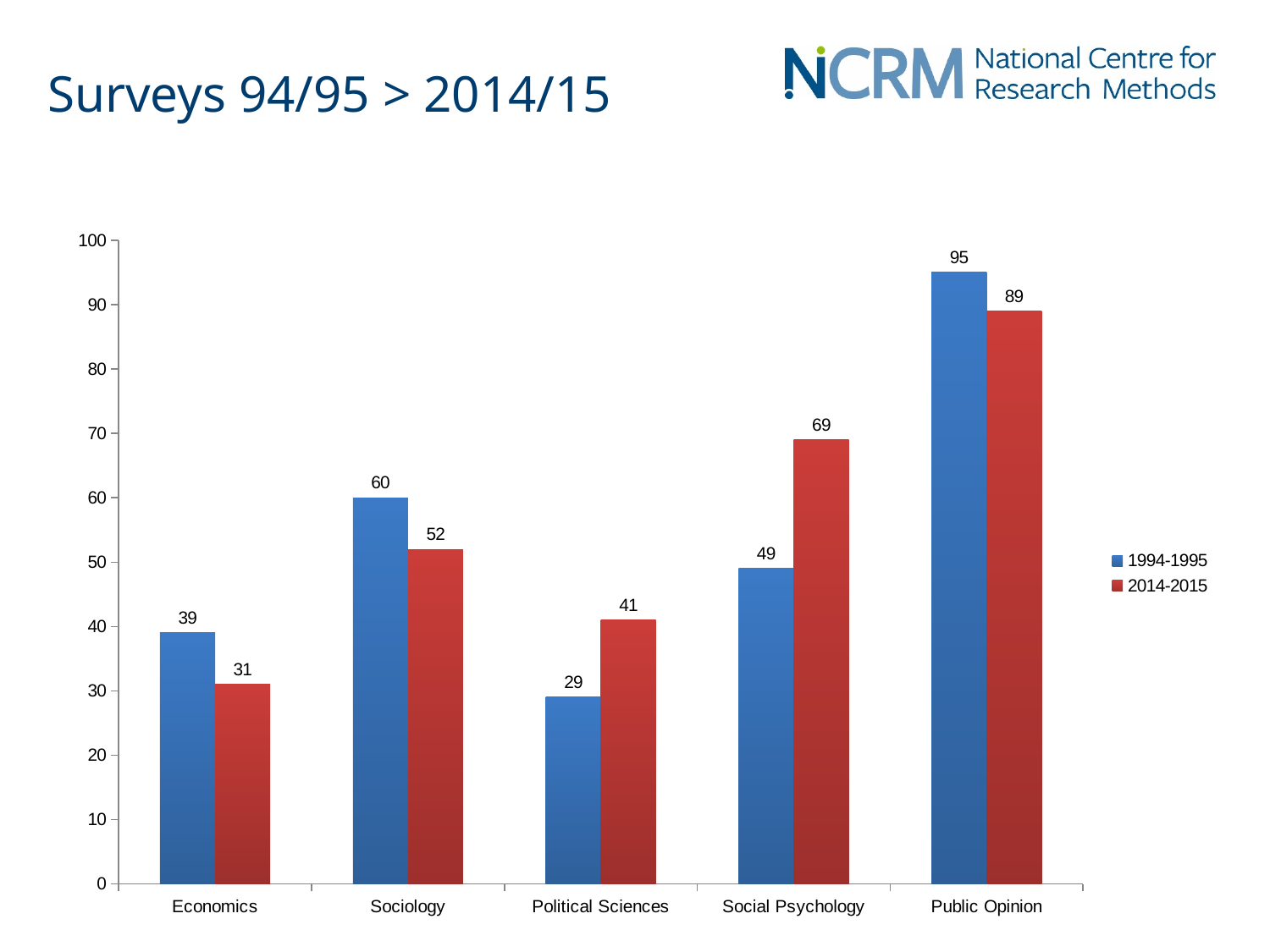
How many categories are shown on the x axis? 5 What is the value for Economics in the 1994-1995 series? 39 What is the value for Social Psychology in the 2014-2015 series? 69 Which category has the lowest value in the 1994-1995 series? Political Sciences Which category has the highest value in the 2014-2015 series? Public Opinion What kind of chart is shown on the slide? bar chart Is the 2014-2015 value for Public Opinion greater or less than 80? greater What is the value for Political Sciences in the 1994-1995 series? 29 Which is larger for Political Sciences: the 1994-1995 value or the 2014-2015 value? 2014-2015 What is the difference between the 1994-1995 and 2014-2015 values for Sociology? 8 What is the difference between the 2014-2015 and 1994-1995 values for Social Psychology? 20 How many series does the legend list? 2